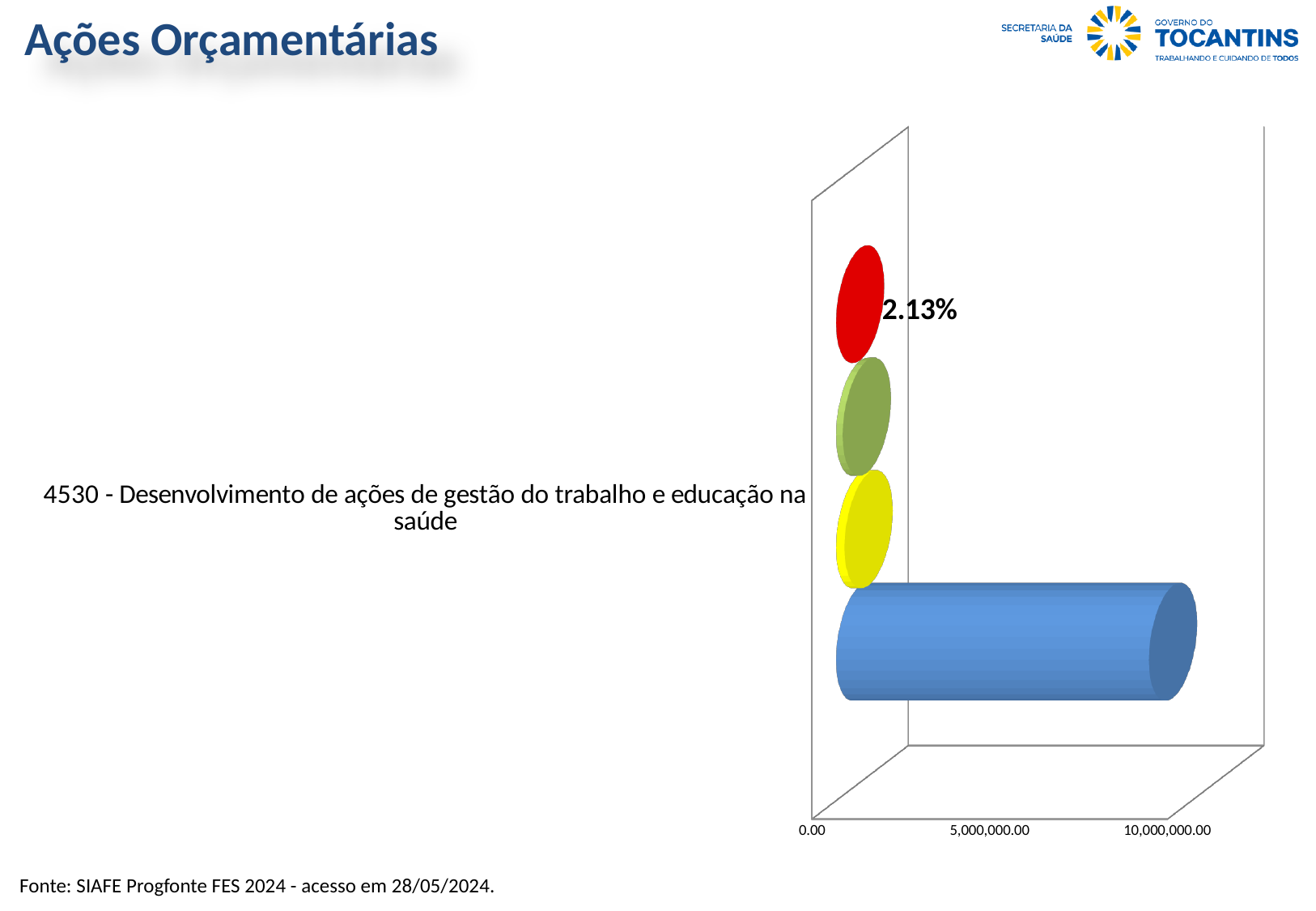
What is the category label shown on the chart? 4530 - Desenvolvimento de ações de gestão do trabalho e educação na saúde Is the value of the blue bar greater or less than 5,000,000.00? greater Which is larger, the blue bar or the yellow bar? the blue bar What kind of chart is shown on the slide? bar chart Which coloured bar is the longest on the chart? the blue bar How many categories are shown on the chart's vertical axis? 1 What is the highest value shown on the horizontal axis? 10,000,000.00 What percentage data label is printed on the chart? 2.13% Is the value of the red bar greater or less than 5,000,000.00? less Is the value of the blue bar greater or less than 10,000,000.00? less